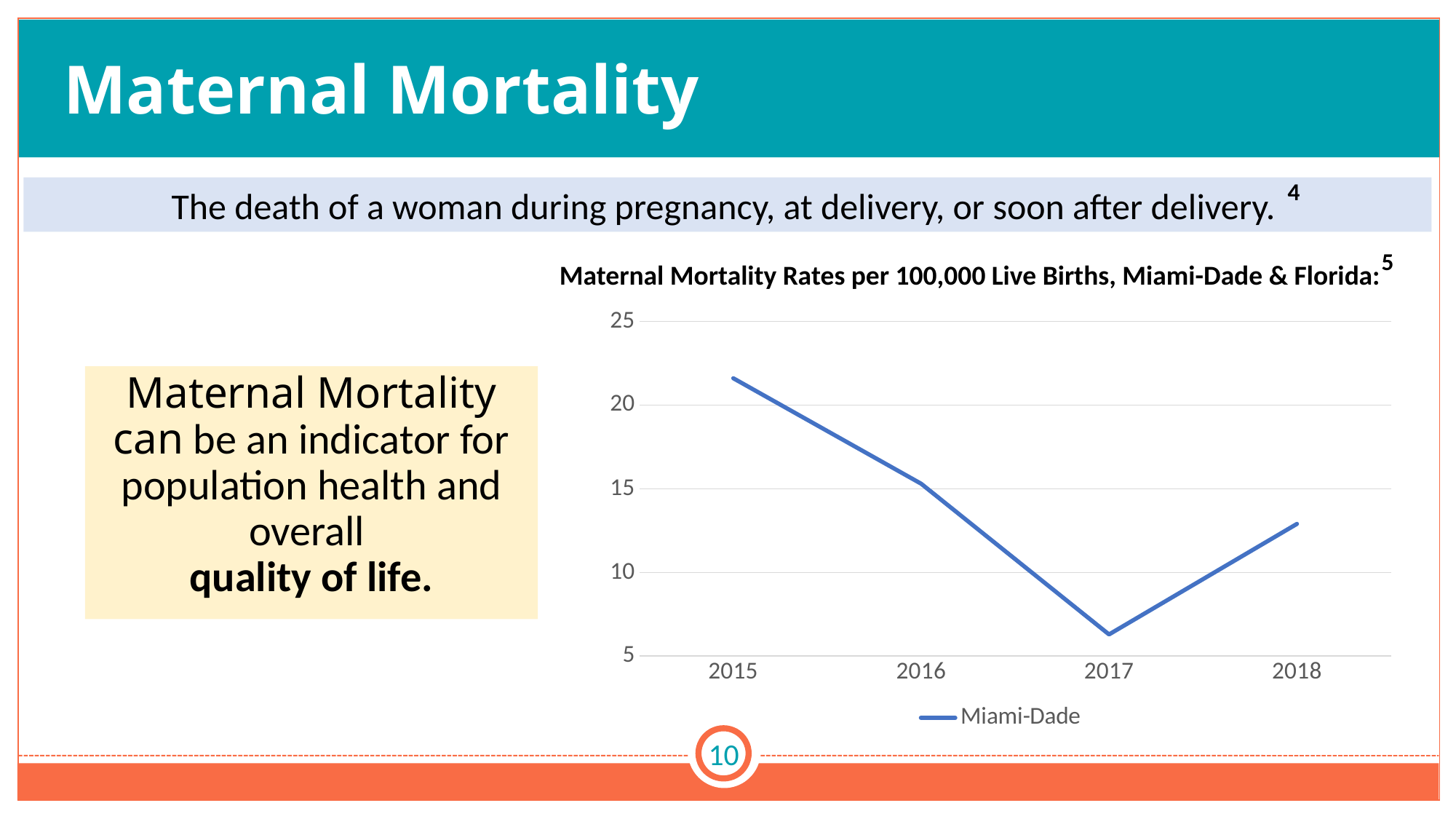
In which year is the Miami-Dade maternal mortality rate lowest? 2017 How many series does the chart's legend list? 1 From 2015 to 2017, does the Miami-Dade rate rise or fall? fall Which year has a higher Miami-Dade rate, 2016 or 2018? 2016 In which year is the Miami-Dade maternal mortality rate highest? 2015 What series name appears in the chart's legend? Miami-Dade How many years are plotted on the x axis of the chart? 4 Is the Miami-Dade rate for 2015 greater or less than 20? greater Is the Miami-Dade rate for 2018 greater or less than 10? greater What is the title of the chart? Maternal Mortality Rates per 100,000 Live Births, Miami-Dade & Florida Is the Miami-Dade rate for 2017 greater or less than 10? less What kind of chart is shown on the slide? line chart